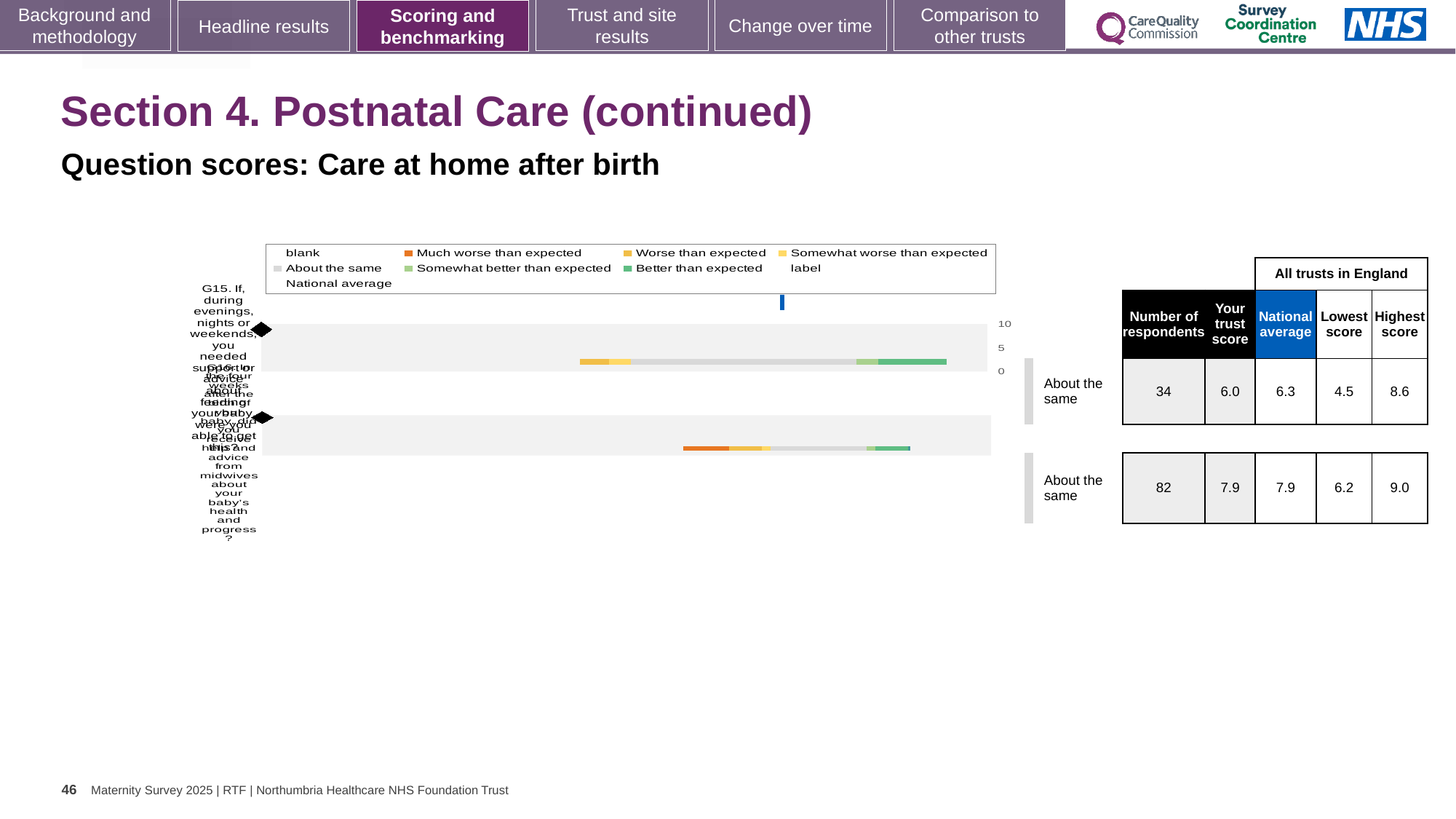
What colour does the legend use for 'Much worse than expected'? orange In the table, what is the national average for the first (top) question? 6.3 In the table, what is the lowest score for the second (bottom) question? 6.2 Which question has more respondents, the first (top) or the second (bottom)? the second (bottom) What kind of chart is shown on the slide? bar chart What is the difference between the highest and lowest score for the first (top) question? 4.1 How many question rows (bars) does the chart show? 2 What is the subtitle of the chart section on the slide? Question scores: Care at home after birth What benchmark category is shown for both questions? About the same In the table, what is the number of respondents for the first (top) question? 34 In the table, what is the highest score for the second (bottom) question? 9.0 In the table, what is the trust score for the first (top) question? 6.0